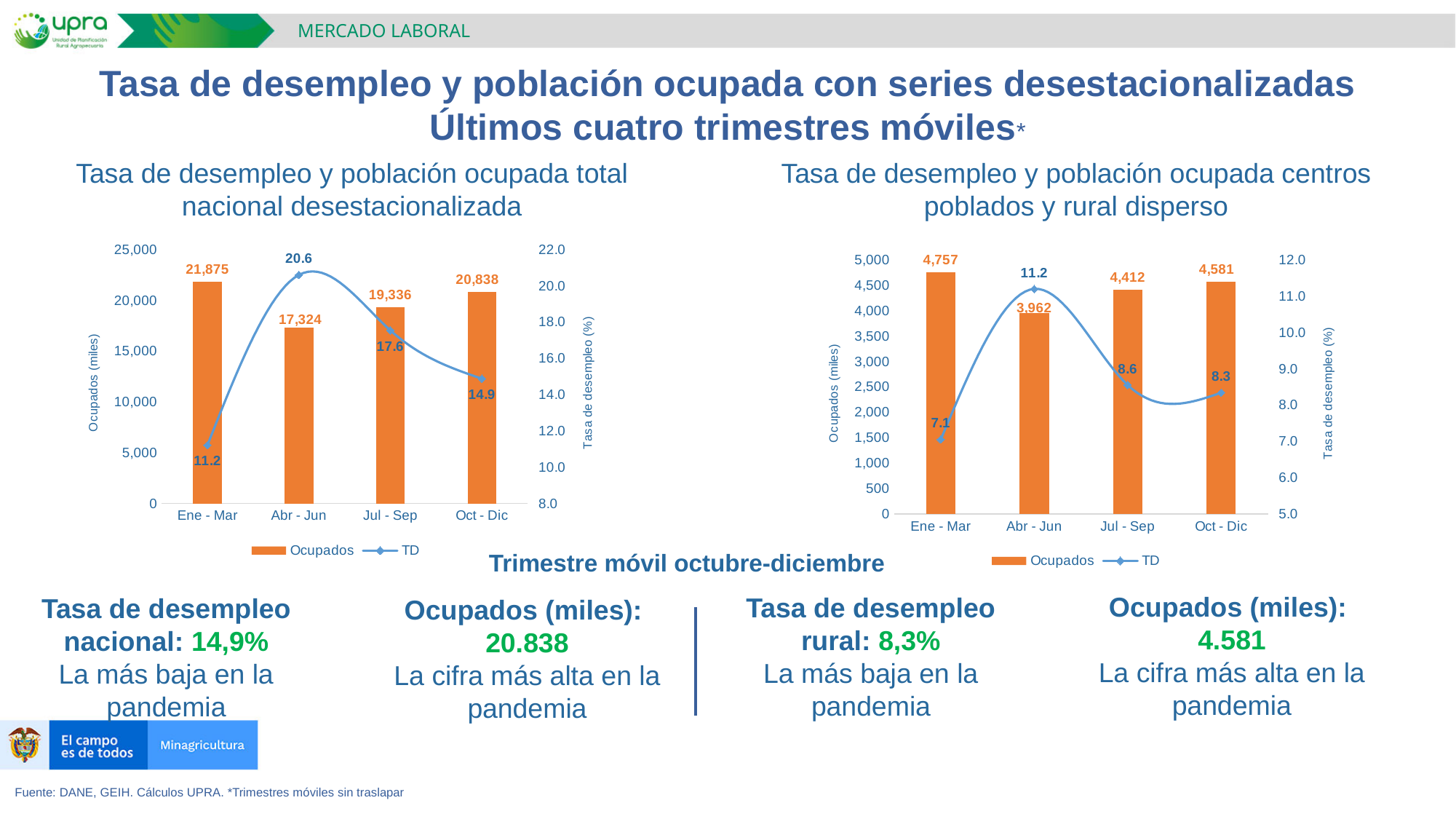
In the right chart (centros poblados y rural disperso), what is the difference between the TD values for Abr - Jun and Ene - Mar? 4.1 How many quarters are shown on the x axis of the right chart (centros poblados y rural disperso)? 4 In the left chart (total nacional desestacionalizada), which quarter has the lowest Ocupados value? Abr - Jun In the right chart (centros poblados y rural disperso), which quarter has the highest TD value? Abr - Jun How many series does the legend of the left chart (total nacional desestacionalizada) list? 2 In the right chart (centros poblados y rural disperso), what is the Ocupados value for Jul - Sep? 4,412 In the left chart (total nacional desestacionalizada), what is the Ocupados value for Ene - Mar? 21,875 In the left chart (total nacional desestacionalizada), does the TD series rise or fall from Abr - Jun to Oct - Dic? fall In the left chart (total nacional desestacionalizada), what is the TD value for Abr - Jun? 20.6 In the right chart (centros poblados y rural disperso), which is larger, the Ocupados value for Ene - Mar or for Oct - Dic? Ene - Mar In the left chart (total nacional desestacionalizada), what is the difference between the Ocupados values for Ene - Mar and Oct - Dic? 1,037 In the right chart (centros poblados y rural disperso), what is the TD value for Oct - Dic? 8.3